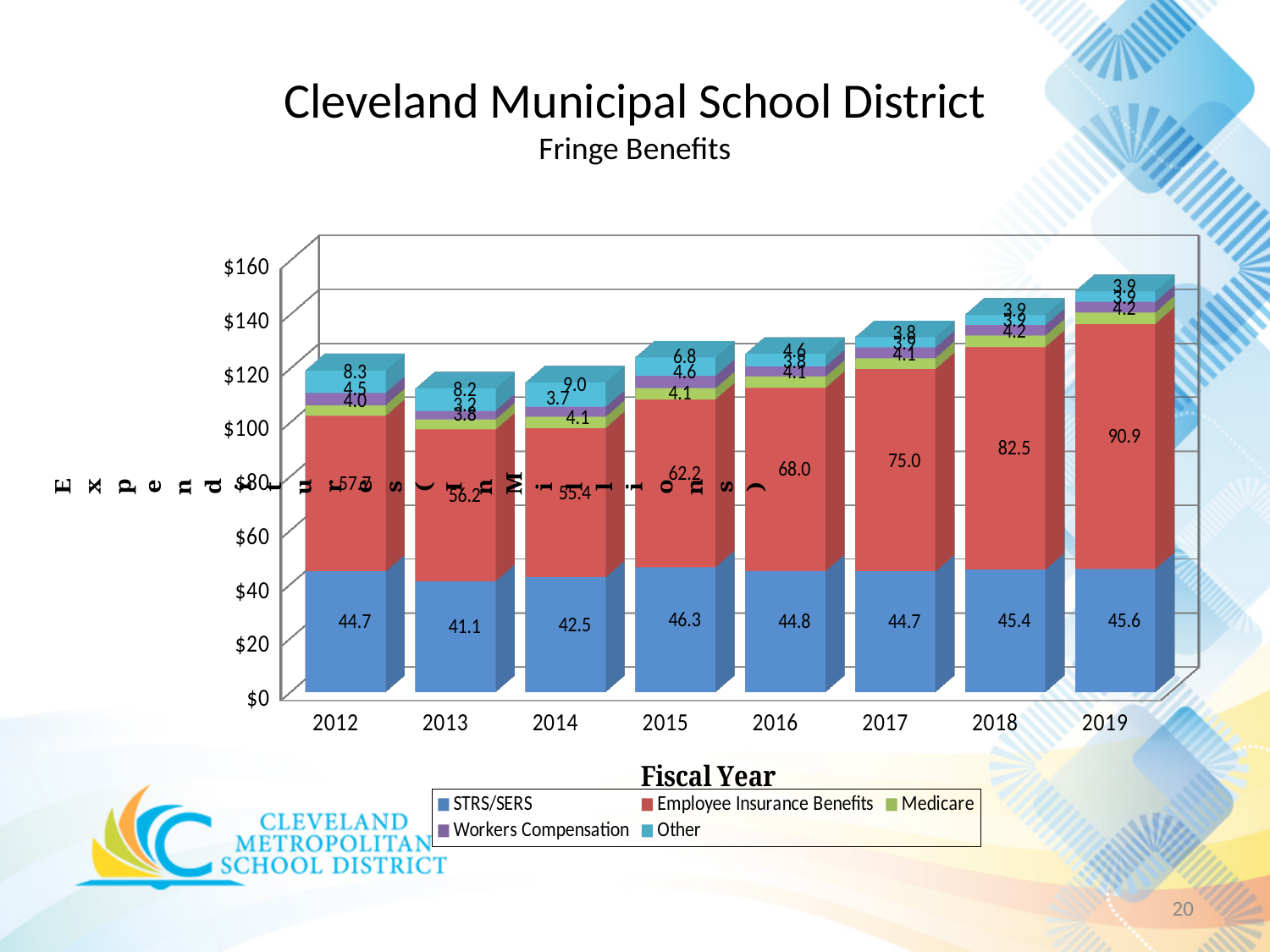
What is the Employee Insurance Benefits value for fiscal year 2019? 90.9 How many series does the legend list? 5 What is the STRS/SERS value for fiscal year 2015? 46.3 In which fiscal year is the STRS/SERS value lowest? 2013 Is the total height of the 2019 stacked bar greater or less than $140? greater What is the value of the Other segment for fiscal year 2014? 9.0 Do the Employee Insurance Benefits values rise or fall from 2014 to 2019? rise How many fiscal years are shown on the x axis? 8 Which fiscal year has the larger STRS/SERS value, 2015 or 2016? 2015 What is the difference between the Employee Insurance Benefits values for 2019 and 2018? 8.4 What kind of chart is shown on the slide? stacked bar chart In which fiscal year is the Employee Insurance Benefits value highest? 2019